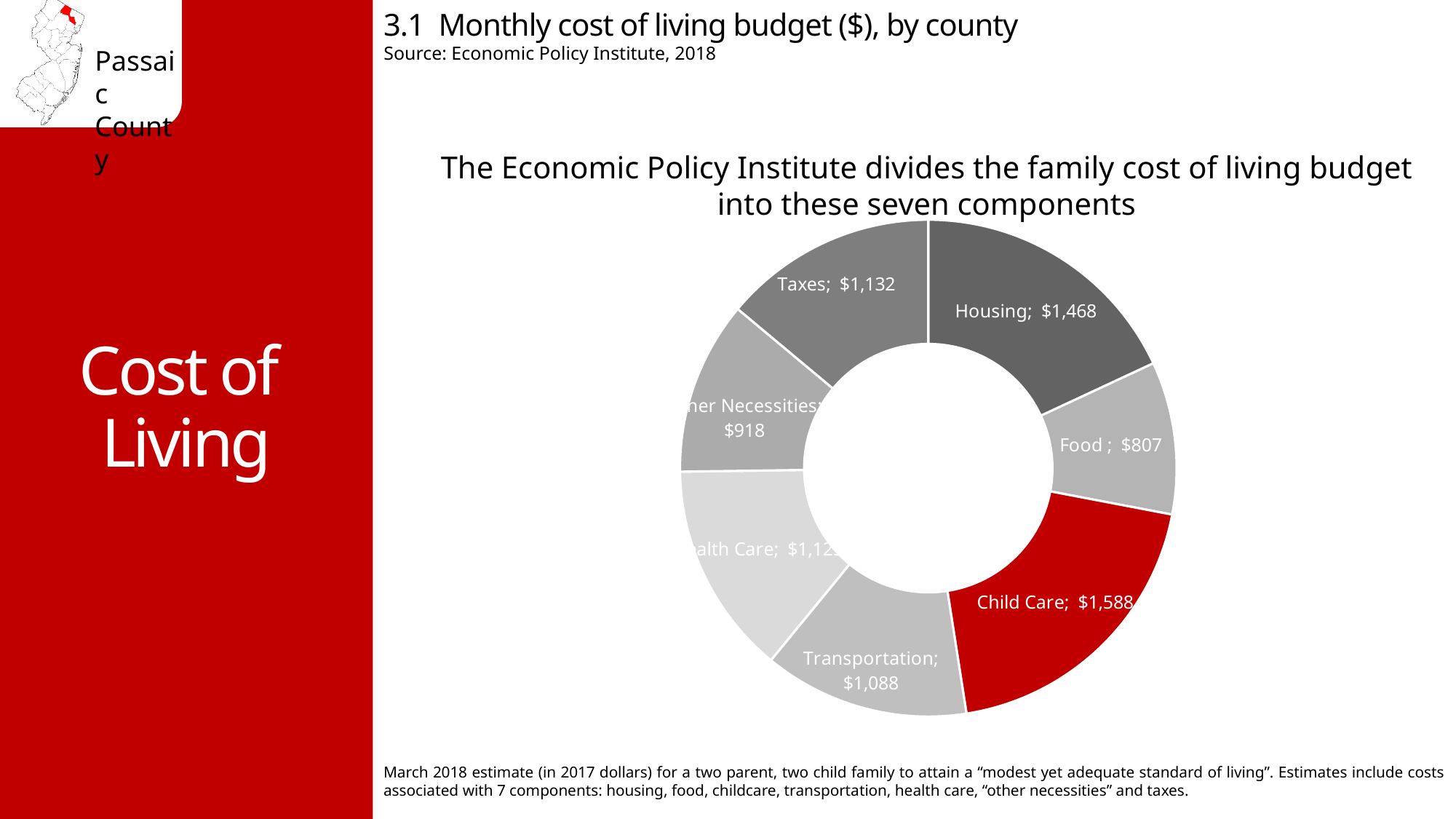
What is the monthly cost for Taxes shown on the chart? $1,132 What is the monthly cost for Child Care shown on the chart? $1,588 What is the monthly cost for Food shown on the chart? $807 What kind of chart is used to show the monthly cost of living budget? Doughnut (pie) chart Which is larger, the monthly cost for Taxes or for Transportation? Taxes What is the monthly cost for Transportation shown on the chart? $1,088 What is the monthly cost for Other Necessities shown on the chart? $918 How much more is the monthly cost of Child Care than Housing? $120 Which component has the lowest monthly cost? Food Which component has the highest monthly cost? Child Care What is the monthly cost for Housing shown on the chart? $1,468 How many components are shown in the chart? 7